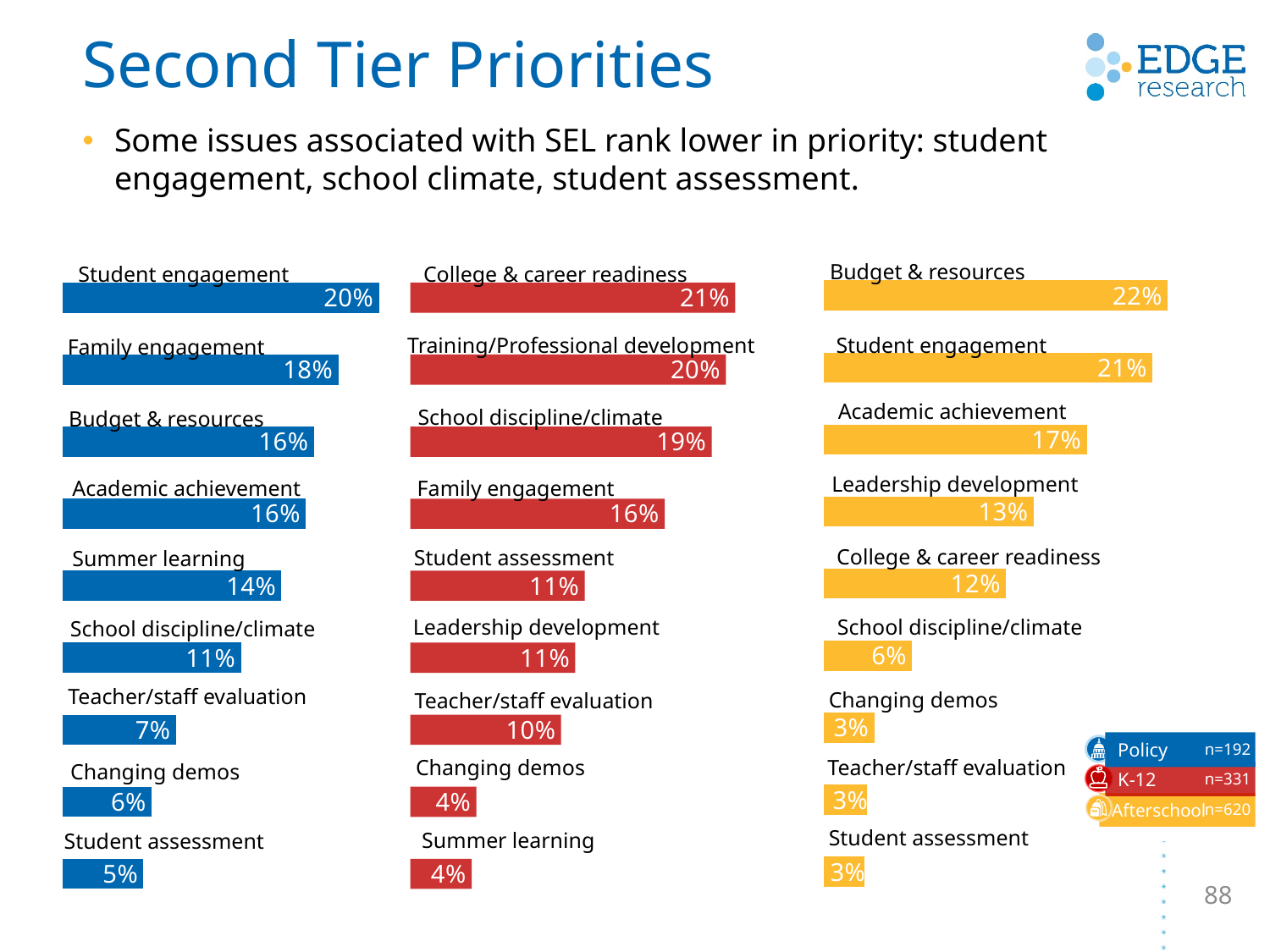
What type of chart is used on this slide? Bar chart In the right (yellow) chart, what is the difference between Student engagement and Academic achievement? 4% In the left (blue) chart, what is the value for Student engagement? 20% In the middle (red) chart, which category has the highest value? College & career readiness In the left (blue) chart, what is the difference between Student engagement and Family engagement? 2% In the right (yellow) chart, what is the value for Leadership development? 13% How many categories are shown in the right (yellow) chart? 9 According to the legend, what is the sample size (n) for the K-12 group? n=331 In the middle (red) chart, what is the value for School discipline/climate? 19% In the left (blue) chart, which category has the lowest value? Student assessment In the right (yellow) chart, which category has the highest value? Budget & resources In the middle (red) chart, which is larger: Training/Professional development or Family engagement? Training/Professional development